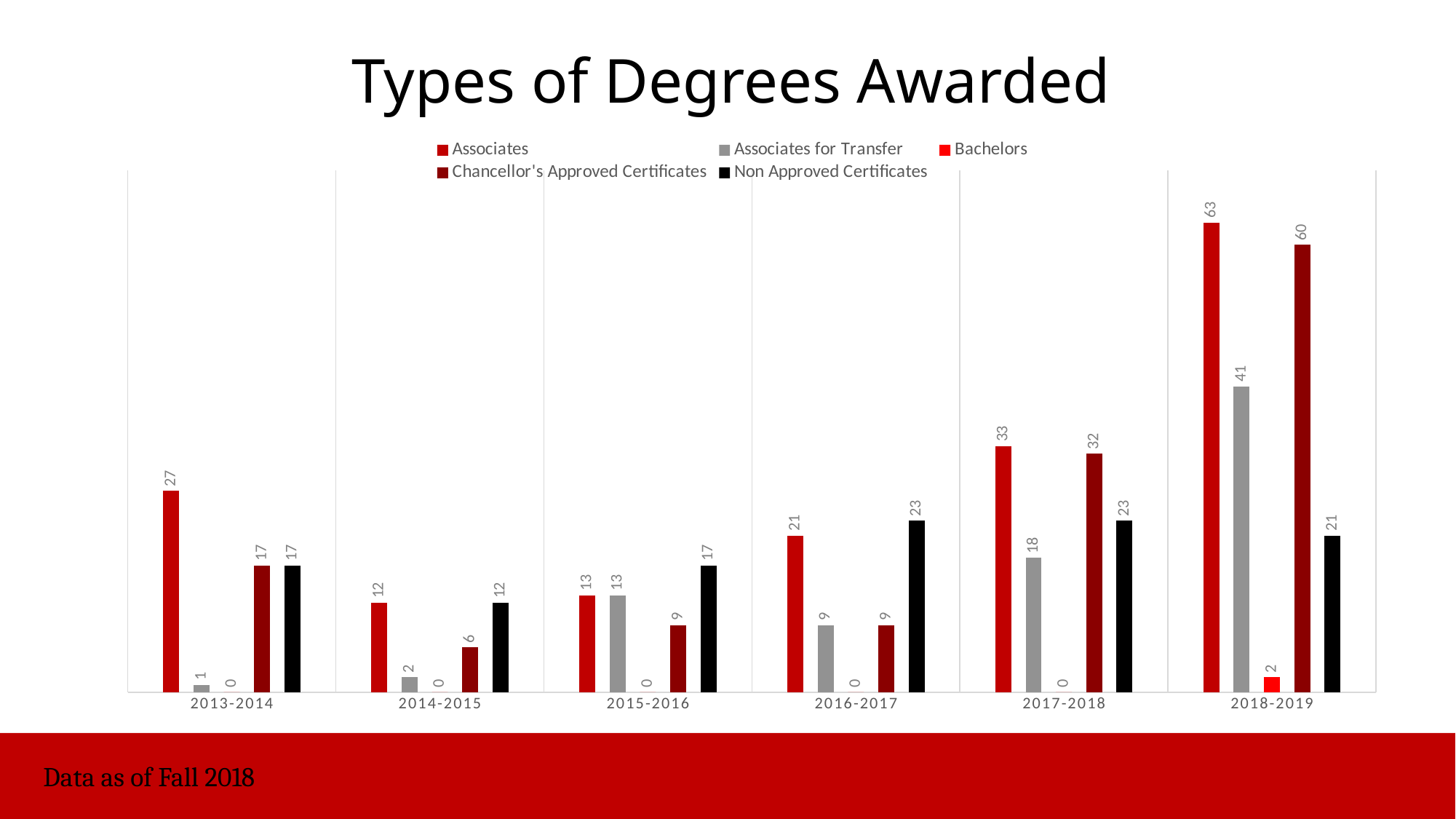
What is the value for Associates for Transfer in 2015-2016? 13 In which year is the Non Approved Certificates value lowest? 2014-2015 Does the Associates value rise or fall from 2014-2015 to 2018-2019? rise What is the value for Associates in 2018-2019? 63 What type of chart is shown on the slide? bar chart In which year is the Associates value highest? 2018-2019 Which is larger in 2016-2017: Associates or Non Approved Certificates? Non Approved Certificates How many academic years are shown on the x axis? 6 What is the value for Chancellor's Approved Certificates in 2017-2018? 32 What is the value for Bachelors in 2018-2019? 2 How many series does the legend list? 5 What is the difference between the Associates value in 2018-2019 and in 2017-2018? 30